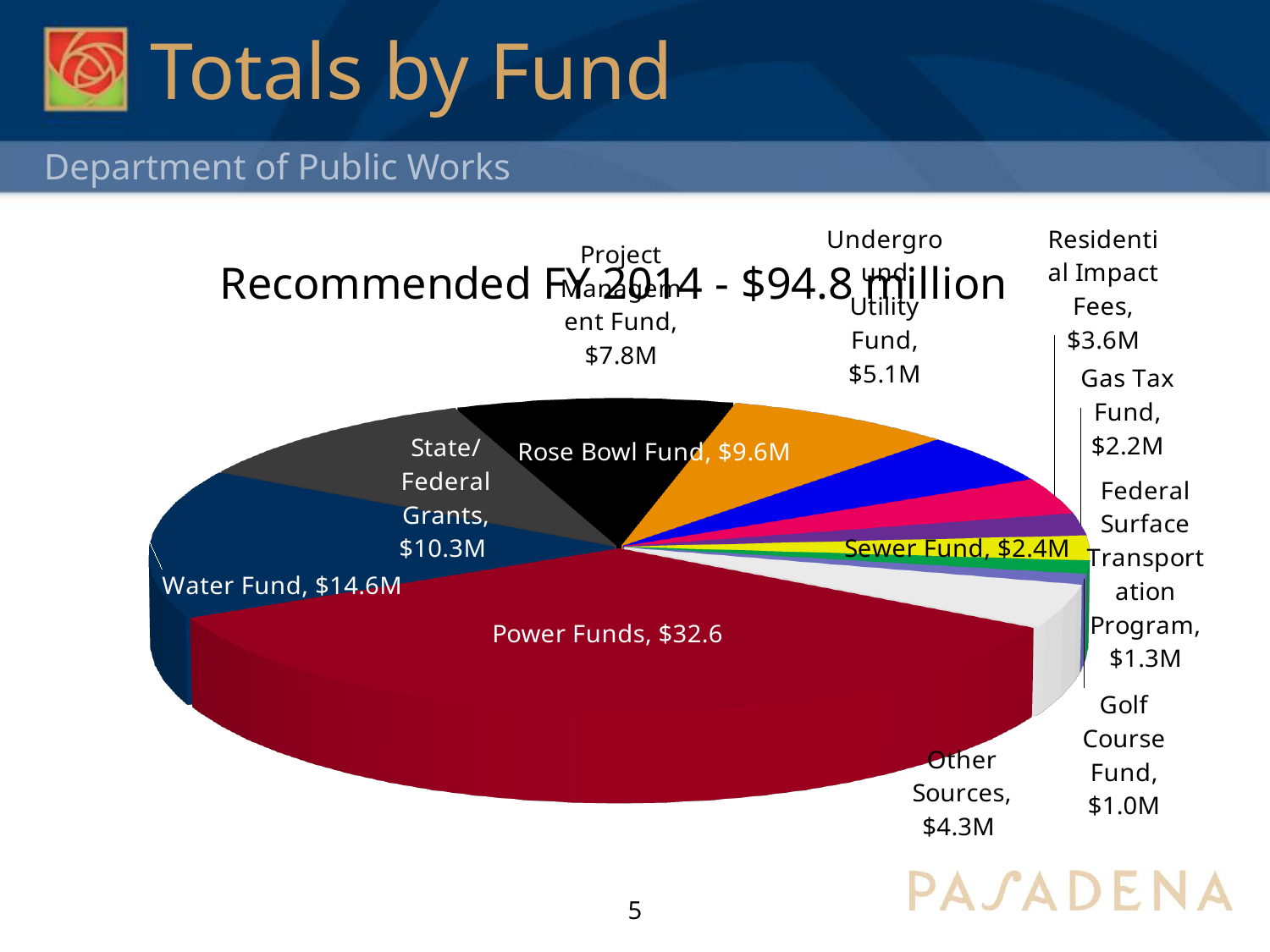
What type of chart is shown on the slide? pie chart What is the value for State/Federal Grants? $10.3M What is the value for the Rose Bowl Fund? $9.6M Which fund has the largest slice of the pie? Power Funds Which is larger, the Underground Utility Fund or Other Sources? Underground Utility Fund What is the difference between the Water Fund and State/Federal Grants? $4.3M What is the value for the Sewer Fund? $2.4M What is the title of the pie chart? Recommended FY 2014 - $94.8 million Which fund has the smallest slice of the pie? Golf Course Fund What is the value for the Water Fund? $14.6M How many slices does the pie chart have? 12 What is the value for the Golf Course Fund? $1.0M